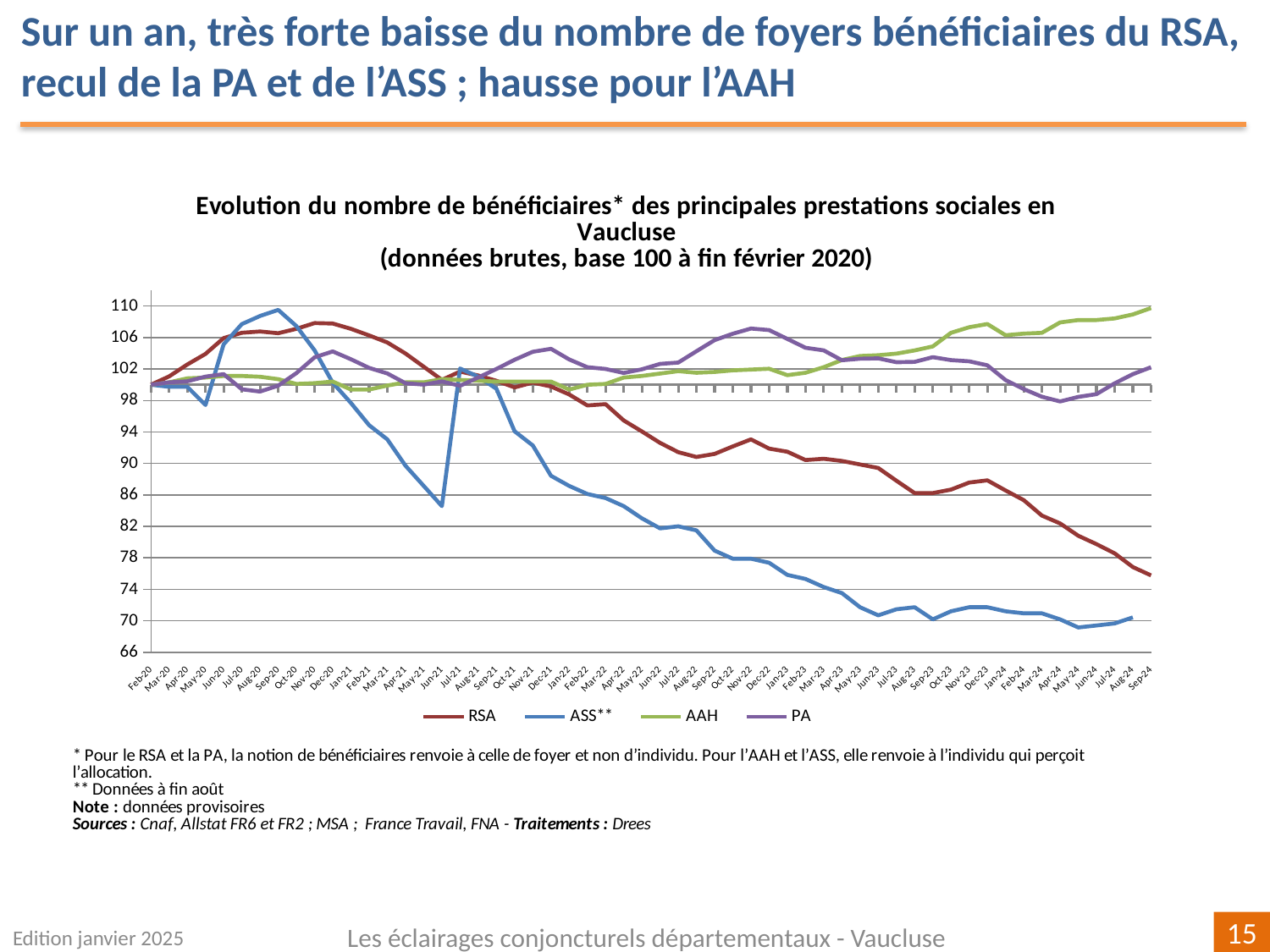
What kind of chart is shown on the slide? line chart Is the value for RSA at Sep-24 greater or less than 78? less Which series has the highest value at Sep-24? AAH According to the chart title, what is the base period for the index of 100? fin février 2020 Does the RSA series rise or fall overall from Feb-20 to Sep-24? fall Is the value for AAH at Sep-24 greater or less than 106? greater What are the series names listed in the legend? RSA, ASS**, AAH, PA Does the AAH series rise or fall overall from Feb-20 to Sep-24? rise Is the value for ASS** at Aug-24 greater or less than 74? less How many series does the legend list? 4 At Sep-24, which is larger: the value for RSA or the value for PA? PA